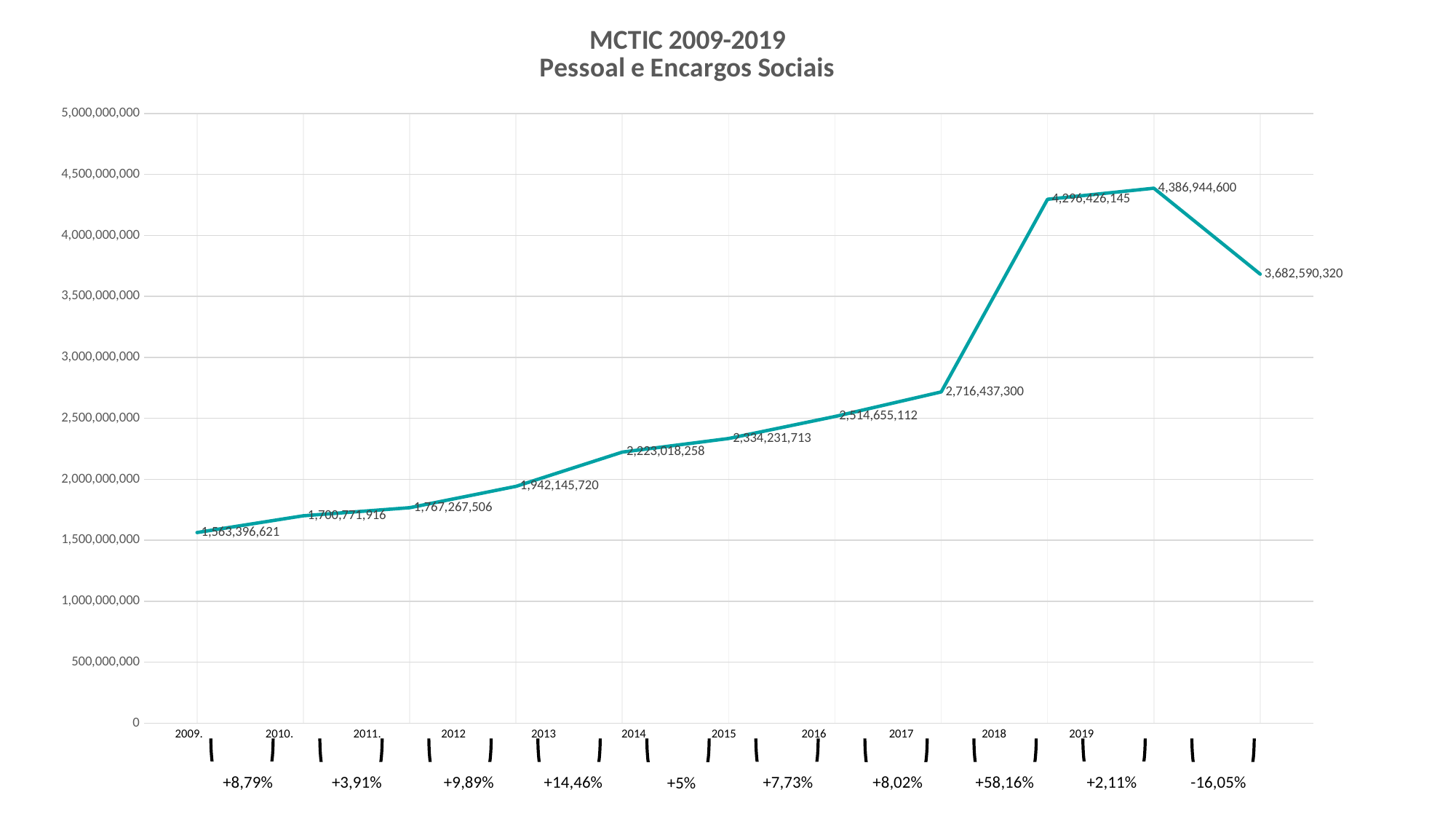
What kind of chart is shown on the slide? line chart Is the value for 2015 greater or less than 3,000,000,000? less Which year has the lowest value? 2009 What is the value for 2009, the first point on the line? 1,563,396,621 What is the difference between the 2018 value and the 2019 value? 704,354,280 What is the value for 2019, the last point on the line? 3,682,590,320 How many data points are plotted on the line? 11 Which year-over-year percentage change shown below the axis is the largest? +58,16% Which year has the highest value? 2018 Which is larger, the value for 2017 or the value for 2018? 2018 What is the title of the chart? MCTIC 2009-2019 Pessoal e Encargos Sociais What is the value for 2016? 2,716,437,300